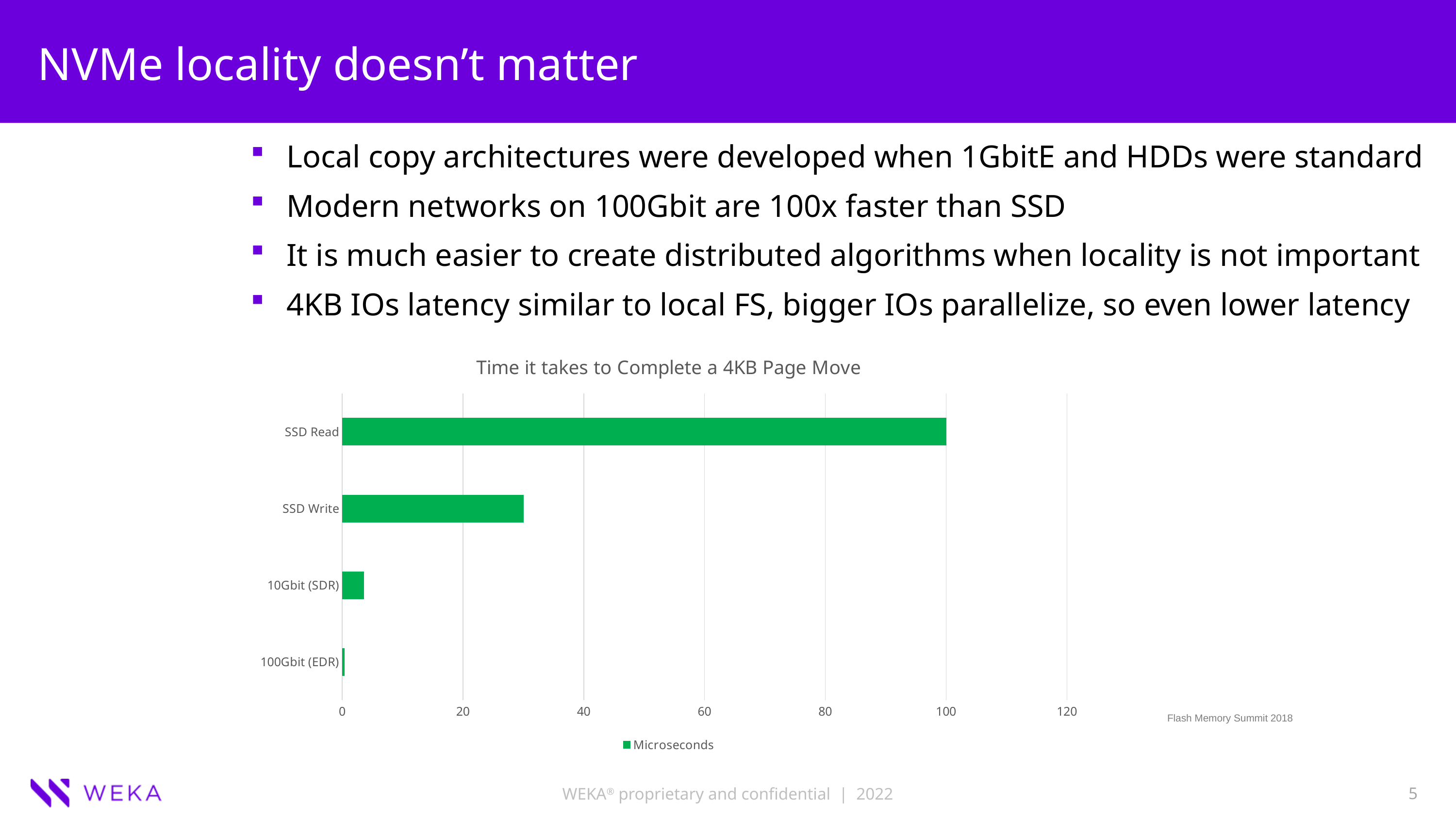
Which category has the highest value in the chart? SSD Read How many series does the chart legend list? 1 What kind of chart is shown on the slide? bar chart Which category has the lowest value in the chart? 100Gbit (EDR) How many categories are plotted in the chart? 4 What series name is shown in the chart legend? Microseconds Is the value for 10Gbit (SDR) greater or less than 20? less Is the value for SSD Write greater or less than 40? less Is the value for SSD Write greater or less than 20? greater What is the value for SSD Read in the chart? 100 What is the title of the chart? Time it takes to Complete a 4KB Page Move Which is larger, the value for SSD Write or the value for 10Gbit (SDR)? SSD Write